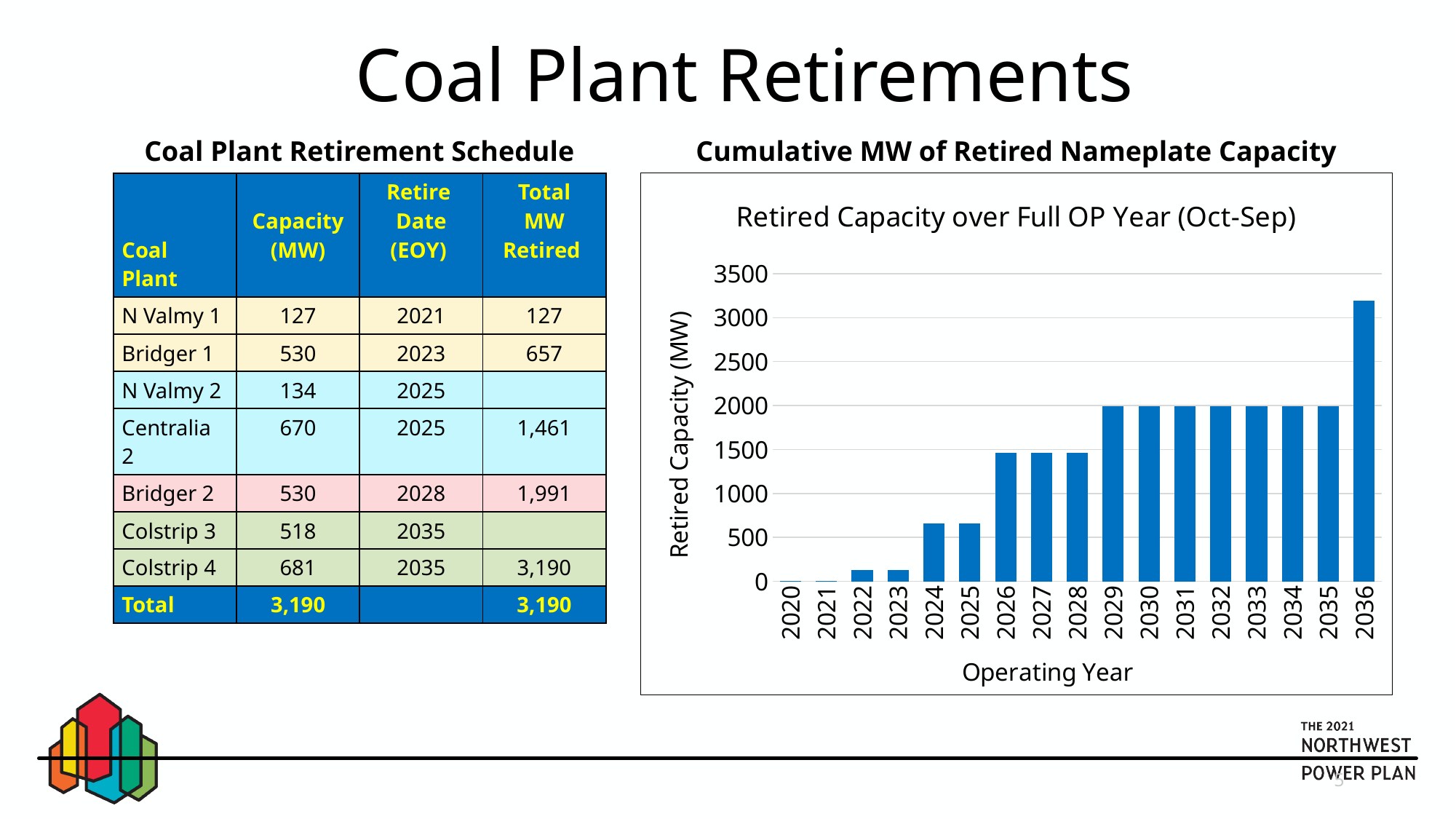
Is the value for 2024 in the bar chart greater or less than 500? greater Is the value for 2022 in the bar chart greater or less than 500? less What kind of chart is shown under "Cumulative MW of Retired Nameplate Capacity"? bar chart What is the label on the y axis of the bar chart? Retired Capacity (MW) How many operating years are plotted on the x axis of the bar chart? 17 Is the value for 2036 in the bar chart greater or less than 3000? greater In the bar chart, which has the larger value, 2035 or 2036? 2036 In the bar chart, which has the larger value, 2023 or 2024? 2024 Do the values in the bar chart rise or fall from 2020 to 2036? rise Which operating year has the highest bar in the chart? 2036